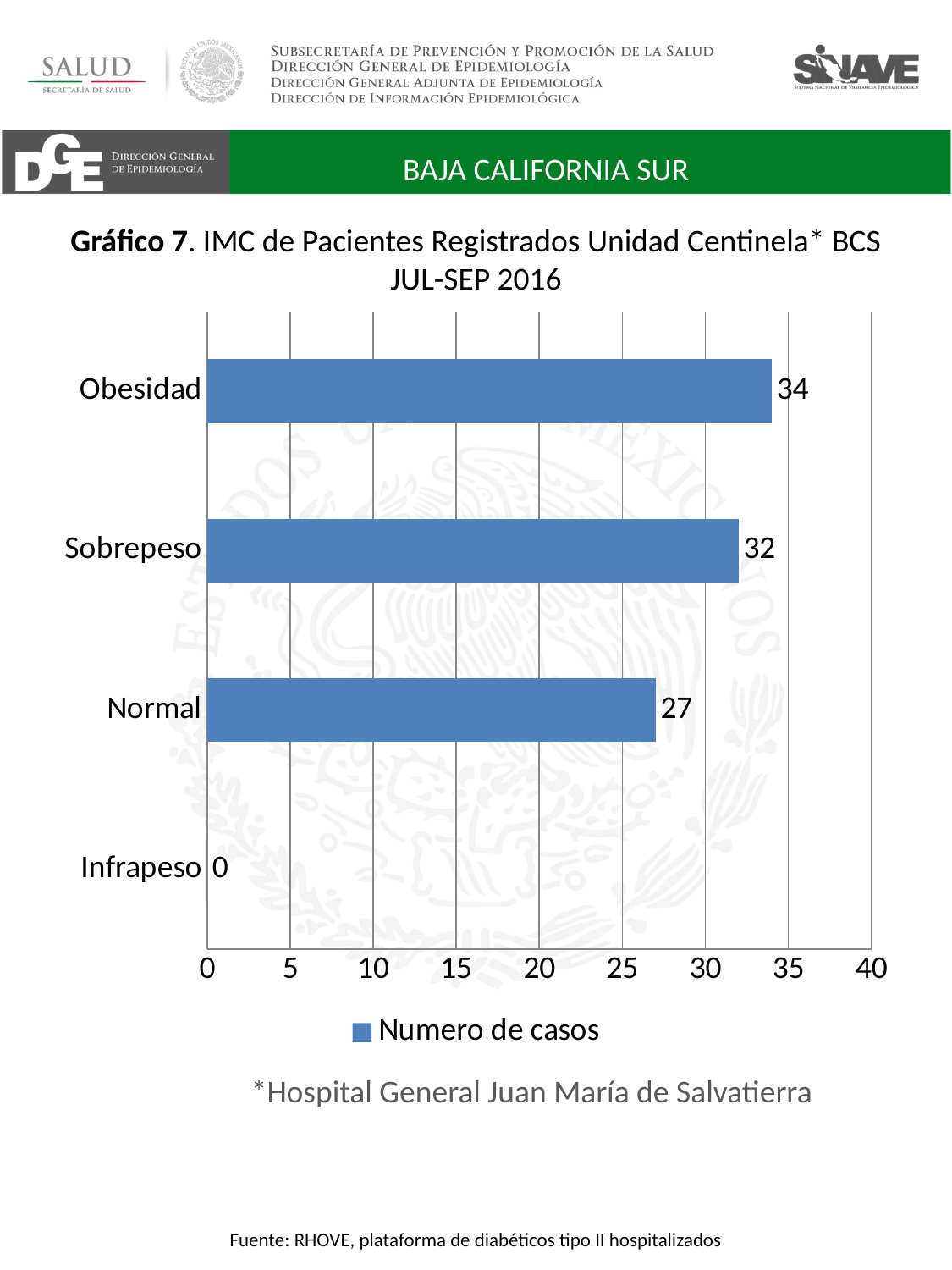
What series name does the legend show? Numero de casos What kind of chart is shown on the slide? Bar chart What is the number of cases for Normal? 27 Is the value for Normal greater or less than 25? greater What is the number of cases for Sobrepeso? 32 What is the difference in number of cases between Obesidad and Normal? 7 What is the number of cases for Infrapeso? 0 How many categories are shown on the chart? 4 What is the number of cases for Obesidad? 34 Which category has the highest number of cases? Obesidad Which has more cases, Sobrepeso or Normal? Sobrepeso Which category has the lowest number of cases? Infrapeso